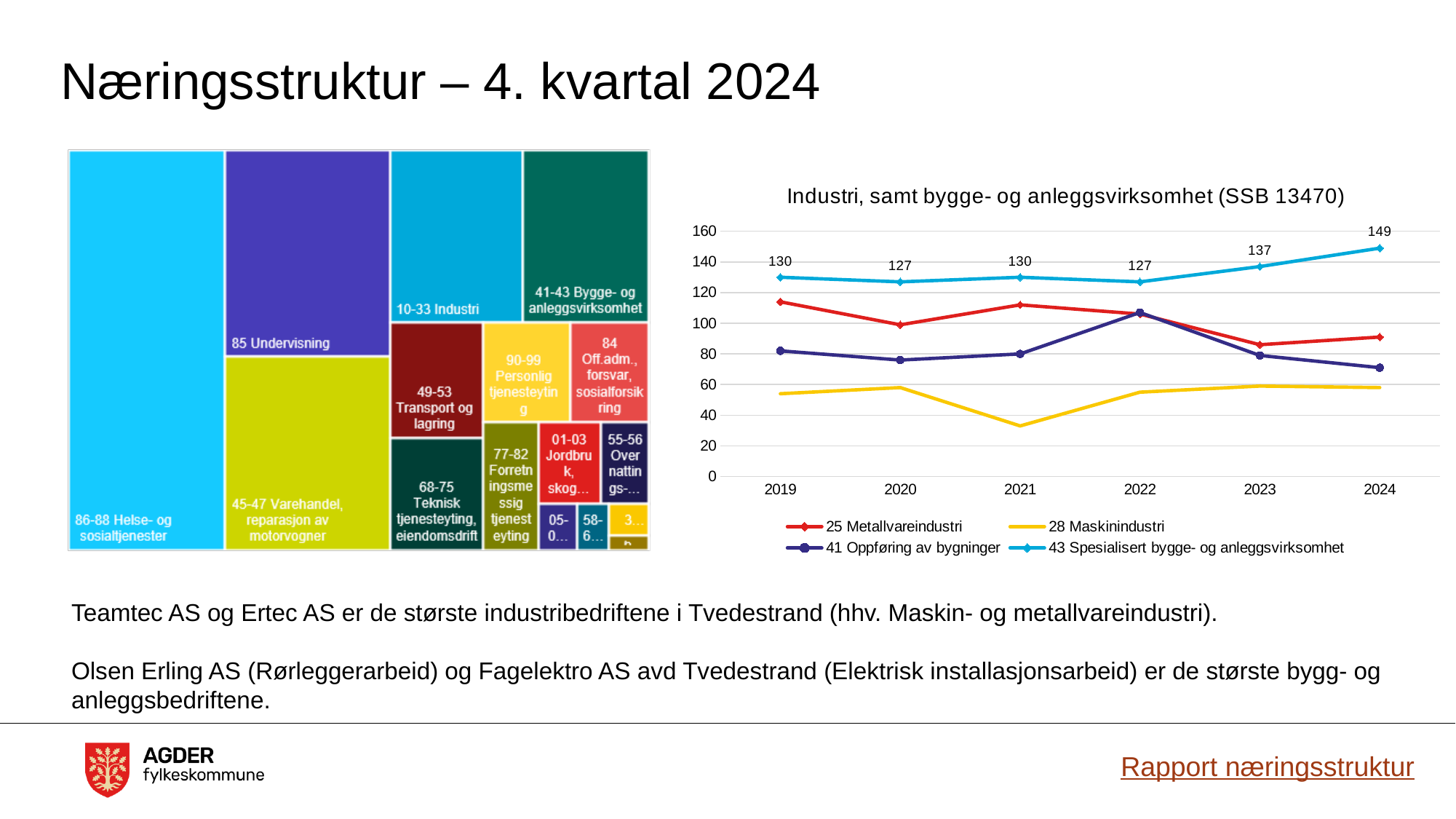
In the line chart 'Industri, samt bygge- og anleggsvirksomhet (SSB 13470)', by how much did 43 Spesialisert bygge- og anleggsvirksomhet increase from 2023 to 2024? 12 In the line chart 'Industri, samt bygge- og anleggsvirksomhet (SSB 13470)', which series has the lowest values across all years? 28 Maskinindustri In the line chart 'Industri, samt bygge- og anleggsvirksomhet (SSB 13470)', is the value for 25 Metallvareindustri in 2019 greater or less than 100? greater In the line chart 'Industri, samt bygge- og anleggsvirksomhet (SSB 13470)', in which year does 43 Spesialisert bygge- og anleggsvirksomhet reach its highest value? 2024 In the line chart 'Industri, samt bygge- og anleggsvirksomhet (SSB 13470)', is the value for 28 Maskinindustri in 2021 greater or less than 40? less What kind of chart is the chart on the right side of the slide? Line chart In the line chart 'Industri, samt bygge- og anleggsvirksomhet (SSB 13470)', how many years are shown on the x axis? 6 In the line chart 'Industri, samt bygge- og anleggsvirksomhet (SSB 13470)', what is the difference between the 2019 and 2024 values for 43 Spesialisert bygge- og anleggsvirksomhet? 19 In the line chart 'Industri, samt bygge- og anleggsvirksomhet (SSB 13470)', which is larger in 2024: 25 Metallvareindustri or 41 Oppføring av bygninger? 25 Metallvareindustri In the line chart 'Industri, samt bygge- og anleggsvirksomhet (SSB 13470)', how many series does the legend list? 4 In the line chart 'Industri, samt bygge- og anleggsvirksomhet (SSB 13470)', what is the value for 43 Spesialisert bygge- og anleggsvirksomhet in 2020? 127 In the line chart 'Industri, samt bygge- og anleggsvirksomhet (SSB 13470)', what is the value for 43 Spesialisert bygge- og anleggsvirksomhet in 2024? 149